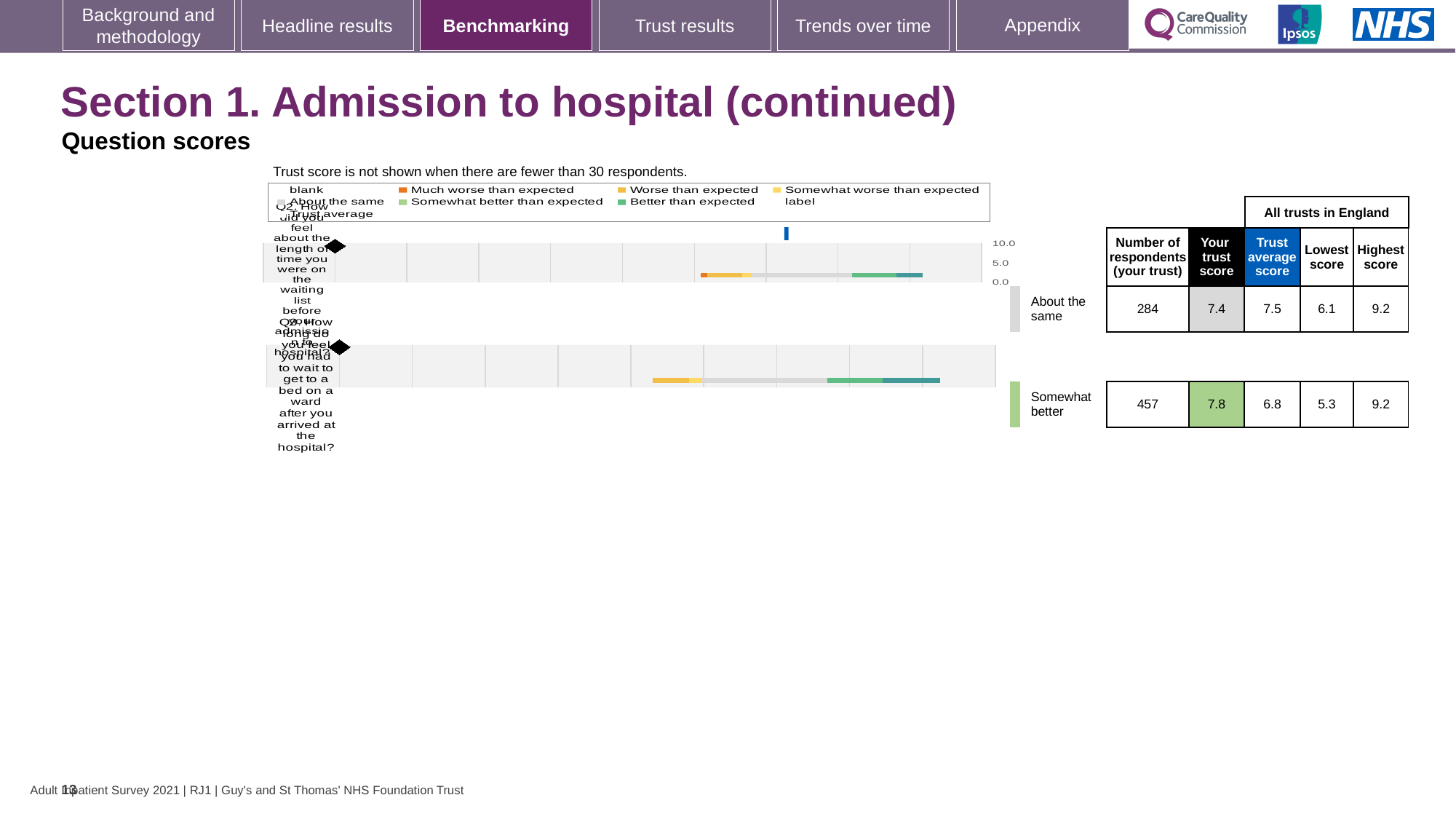
What kind of chart is used to show the question scores for Q2 and Q3? bar chart For the Q2 chart, what is the highest score among all trusts in England? 9.2 For the Q2 chart, how many respondents did the trust have? 284 For the Q3 chart (wait to get to a bed on a ward), what is the trust score shown in the table? 7.8 For the Q3 chart, what is the lowest score among all trusts in England? 5.3 For the Q3 chart, which is larger: the trust's own score or the trust average score? the trust's own score How many questions (charts) are shown on the slide? 2 For the Q2 chart (length of time on the waiting list), what is the trust score shown in the table? 7.4 For the Q3 chart, what is the difference between the trust score and the trust average score? 1.0 For the Q3 chart, what is the trust average score for all trusts in England? 6.8 What benchmark category label is shown next to the Q3 chart? Somewhat better